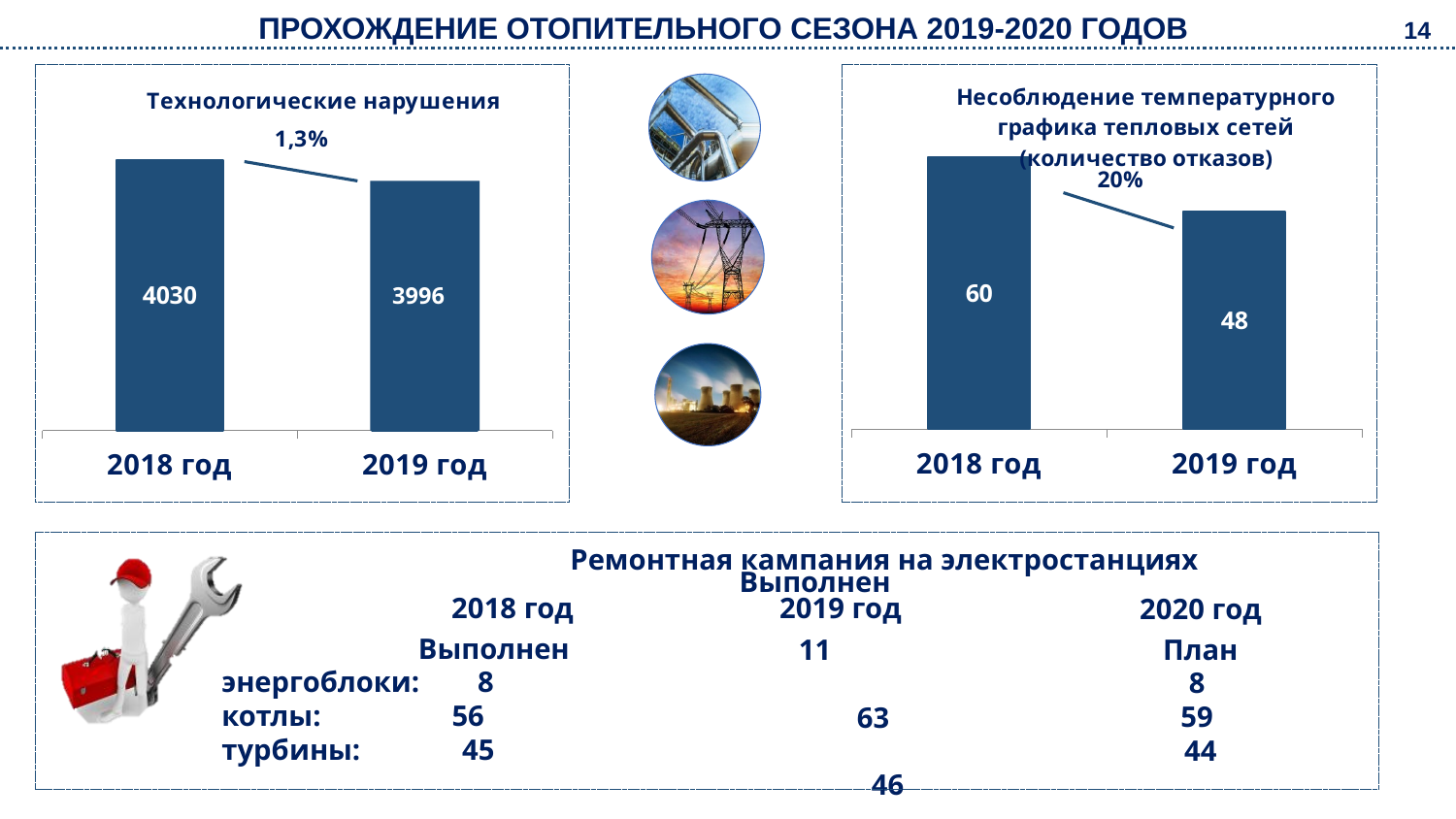
How many categories are shown in the 'Несоблюдение температурного графика тепловых сетей' chart? 2 In the 'Несоблюдение температурного графика тепловых сетей' chart, what is the value for 2018 год? 60 In the 'Технологические нарушения' chart, what is the difference between the 2018 год and 2019 год values? 34 In the 'Несоблюдение температурного графика тепловых сетей' chart, what is the value for 2019 год? 48 What kind of chart is the 'Технологические нарушения' chart? Bar chart In the 'Несоблюдение температурного графика тепловых сетей' chart, what is the difference between the 2018 год and 2019 год values? 12 In the 'Технологические нарушения' chart, which year has the higher value? 2018 год In the 'Технологические нарушения' chart, what is the value for 2019 год? 3996 In the 'Несоблюдение температурного графика тепловых сетей' chart, which year has the lowest value? 2019 год In the 'Технологические нарушения' chart, what percentage change is annotated between the two bars? 1,3% In the 'Технологические нарушения' chart, what is the value for 2018 год? 4030 In the 'Несоблюдение температурного графика тепловых сетей' chart, what percentage change is annotated between the two bars? 20%